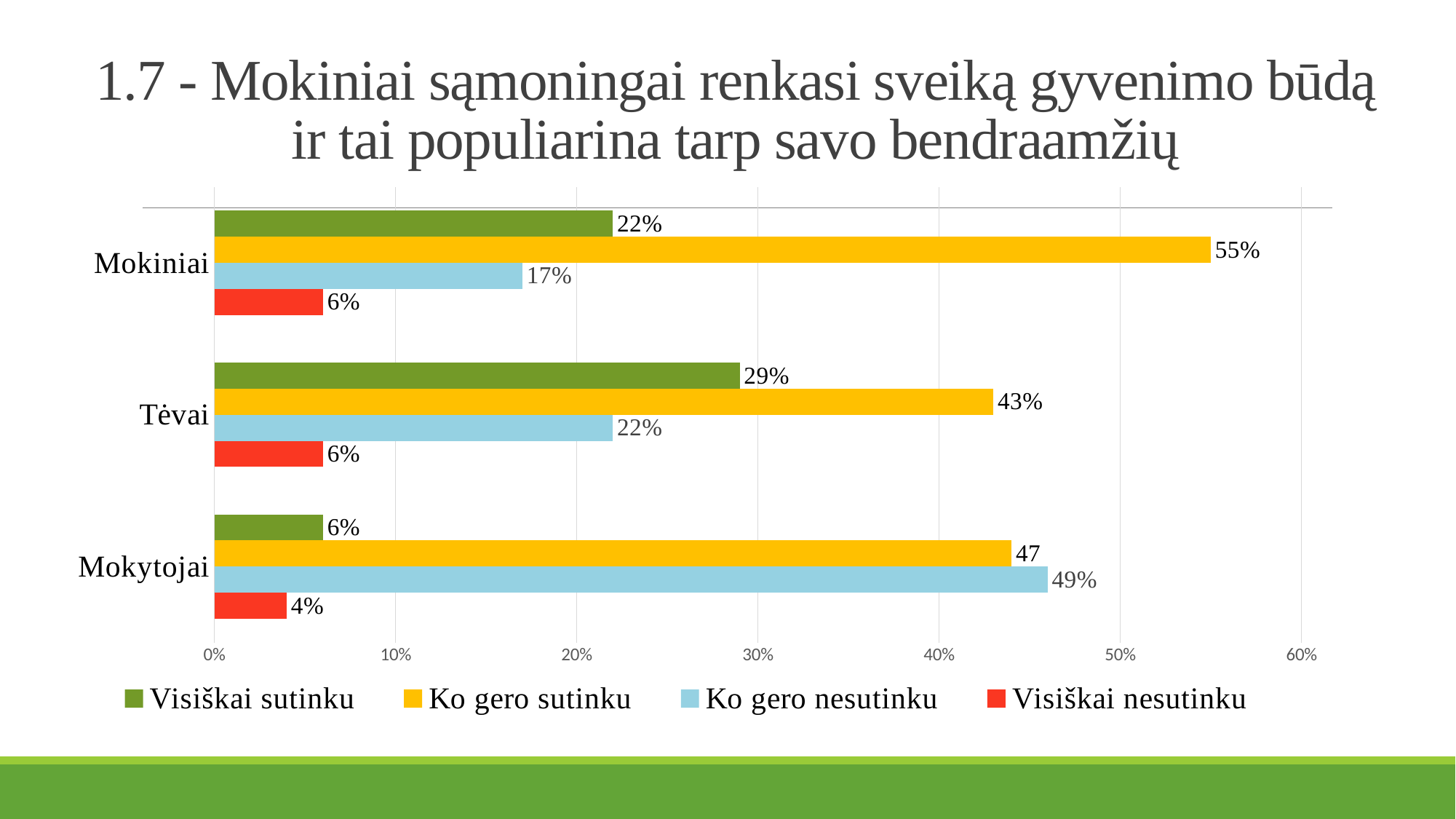
How many series does the legend list? 4 How many categories are shown on the chart? 3 What is the value of 'Ko gero nesutinku' for Mokytojai? 49% Which series is shown in red in the legend? Visiškai nesutinku Which category has the highest value for 'Visiškai sutinku'? Tėvai What is the value of 'Visiškai nesutinku' for Mokytojai? 4% Which is larger: 'Ko gero nesutinku' for Mokiniai or for Tėvai? Tėvai What is the difference between the 'Ko gero sutinku' values for Mokiniai and Tėvai? 12% Which category has the lowest value for 'Ko gero sutinku'? Tėvai What is the value of 'Visiškai sutinku' for Tėvai? 29% What is the value of 'Ko gero sutinku' for Mokiniai? 55% What kind of chart is shown on the slide? bar chart